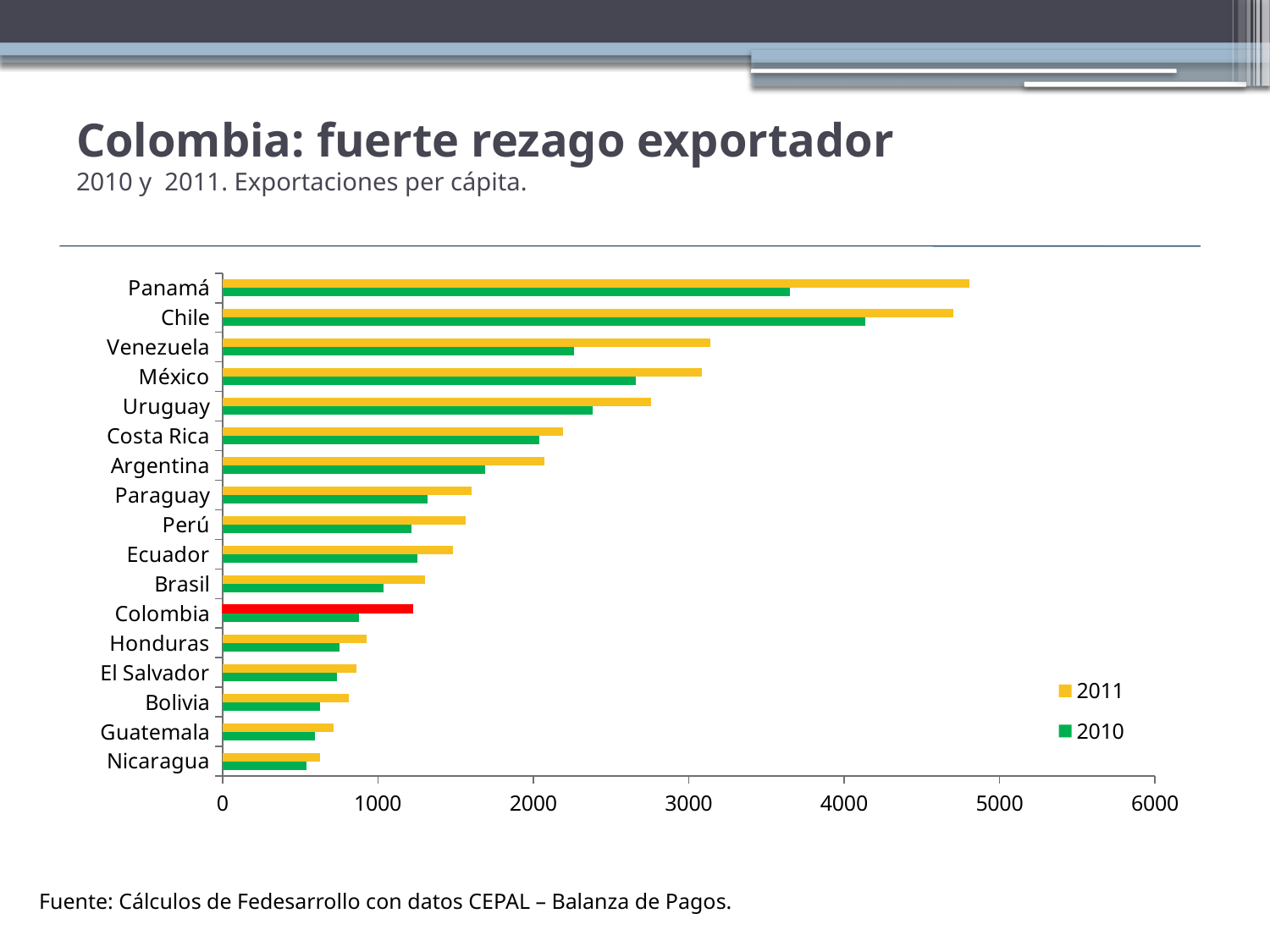
What kind of chart is shown on the slide? bar chart Is the 2010 value for Panamá greater or less than 4000? less How many series does the legend list? 2 Which country's 2011 bar is highlighted in red? Colombia Which country has the highest value for 2010? Chile Is the 2011 value for Colombia greater or less than 1000? greater Is the 2011 value for Venezuela greater or less than 3000? greater Which country has the lowest value for 2011? Nicaragua Which is larger: the 2010 value for Chile or the 2010 value for Panamá? Chile Which country has the lowest value for 2010? Nicaragua How many countries are shown on the chart? 17